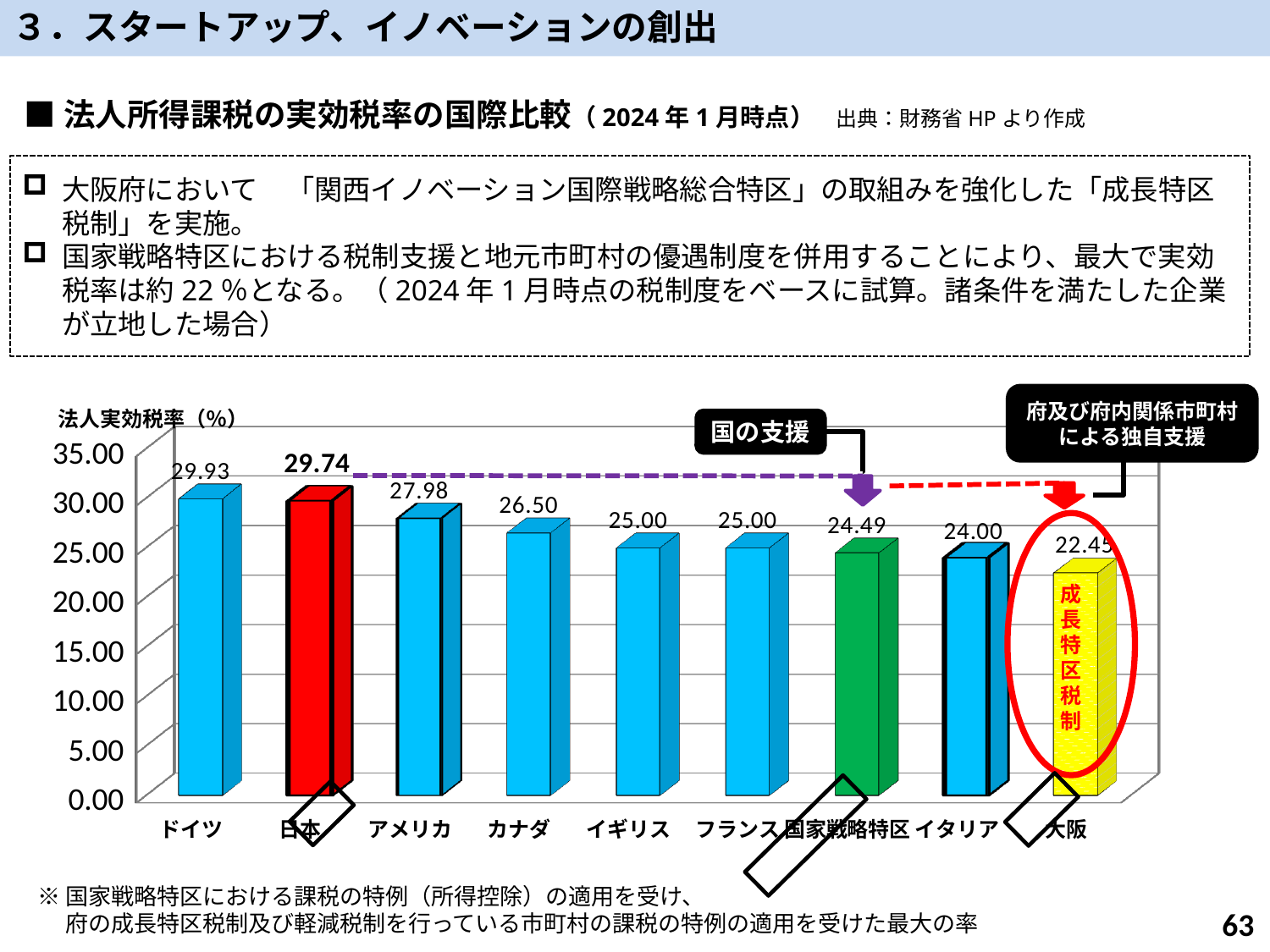
What is the difference between the values for イタリア and 大阪? 1.55 Which category has the highest value? ドイツ What kind of chart is shown on the slide? bar chart What is the value shown for 日本? 29.74 What is the value shown for ドイツ? 29.93 How many categories are shown on the x axis? 9 Which is larger, the value for カナダ or the value for イギリス? カナダ What is the value shown for 国家戦略特区? 24.49 What is the value shown for 大阪? 22.45 What is the label on the vertical axis of the chart? 法人実効税率（%） Which category has the lowest value? 大阪 What is the difference between the values for アメリカ and カナダ? 1.48